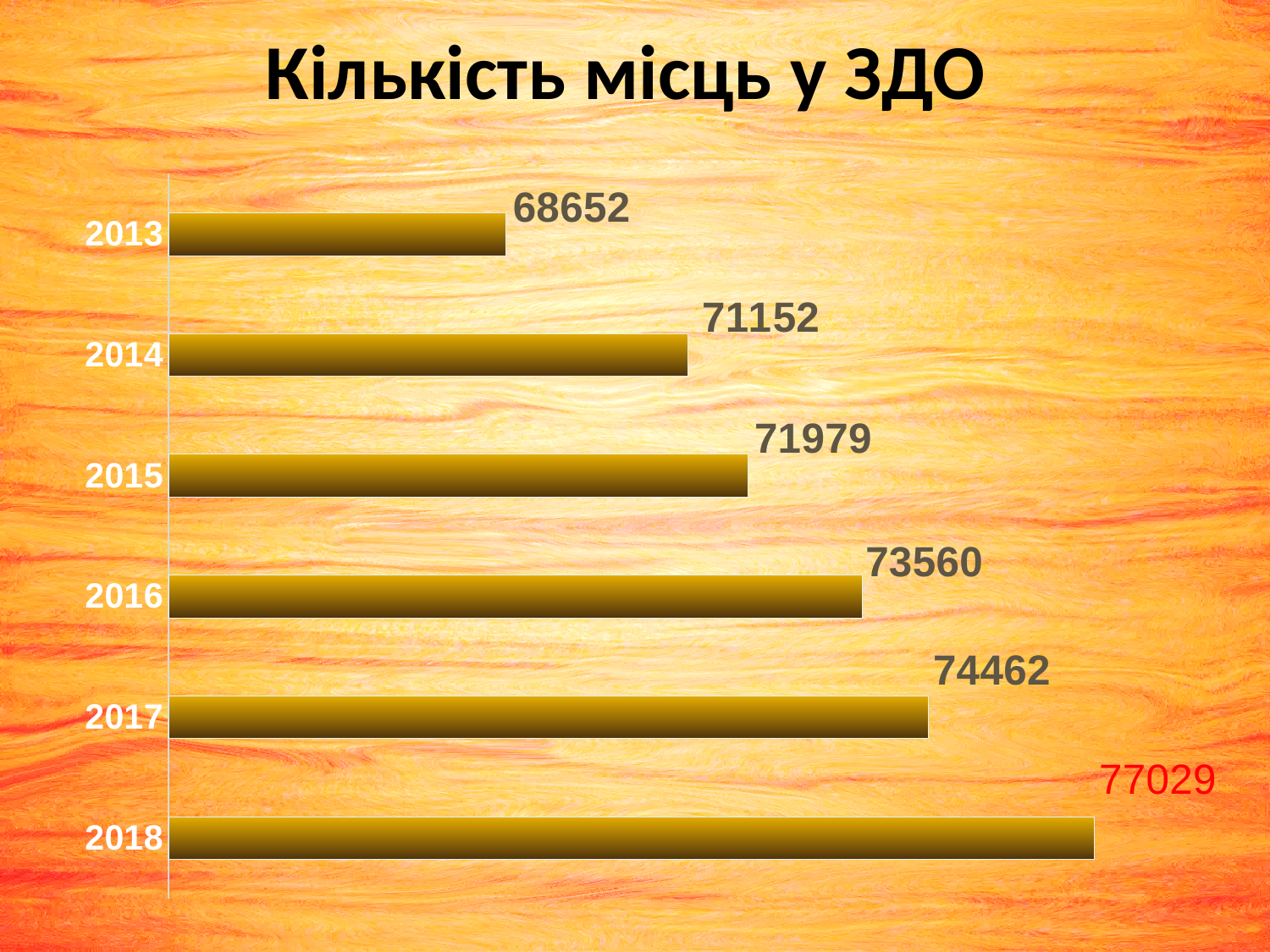
How many years are shown in the chart? 6 What is the difference between the values for 2014 and 2013? 2500 What is the value for 2016? 73560 What is the value for 2018? 77029 What kind of chart is this? bar chart Do the values rise or fall from 2013 to 2018? rise Which is larger, the value for 2015 or the value for 2016? 2016 What is the difference between the values for 2018 and 2017? 2567 What is the title of the chart? Кількість місць у ЗДО Which year has the lowest value? 2013 Which year has the highest value? 2018 What is the value for 2013? 68652